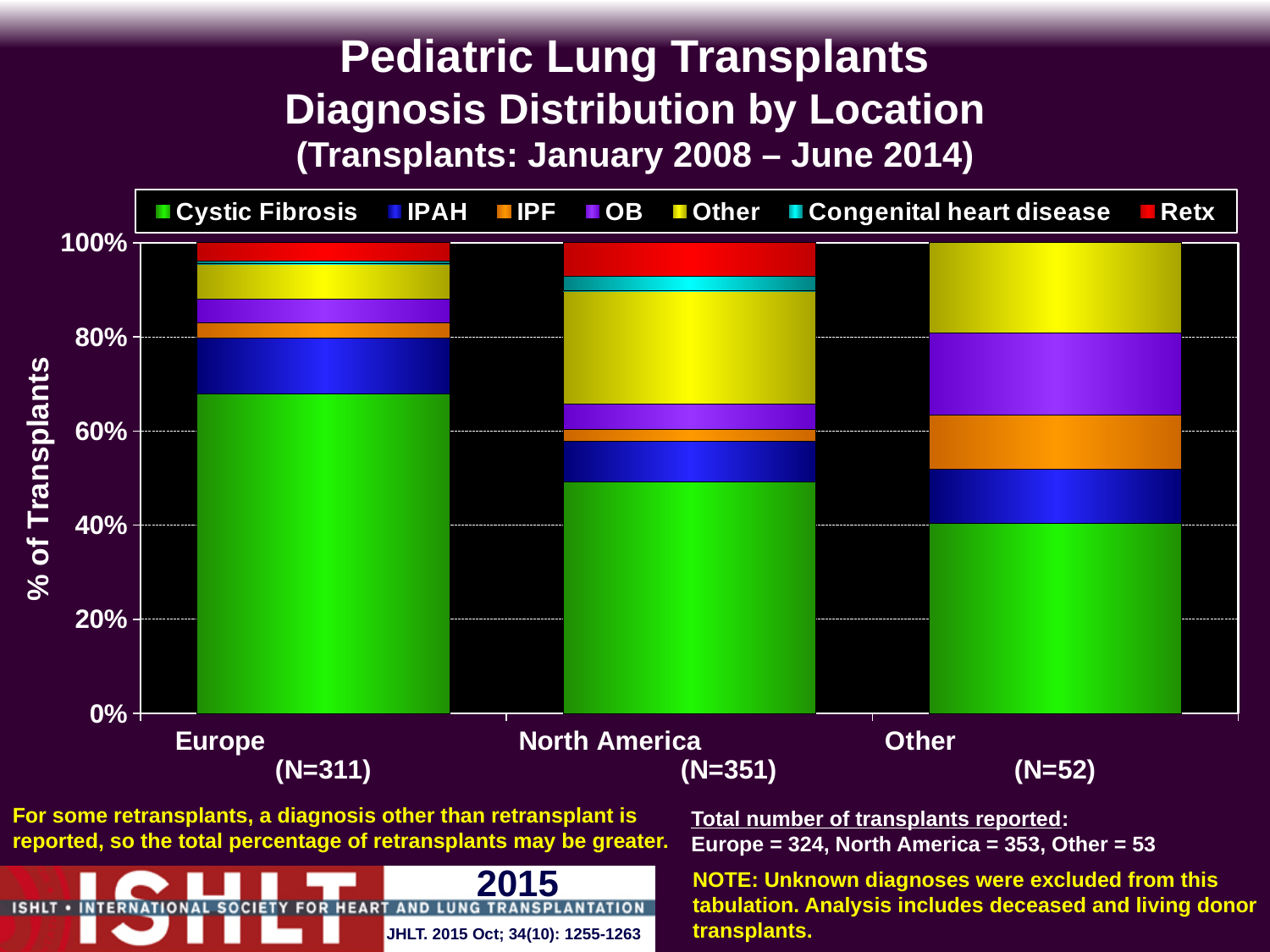
Is the Cystic Fibrosis share for Europe greater or less than 60%? greater How many diagnosis series does the legend list? 7 Is the OB segment larger for Europe or for Other? Other Is the Cystic Fibrosis share for North America greater or less than 40%? greater What is the label of the y axis? % of Transplants What is the N value shown for North America on the x axis? N=351 Which location has the largest Cystic Fibrosis share? Europe Which location has the smallest Cystic Fibrosis share? Other Is the Cystic Fibrosis share for North America greater or less than 60%? less What is the N value shown for Europe on the x axis? N=311 What kind of chart is shown on the slide? Stacked bar chart How many locations are shown on the x axis of the chart? 3